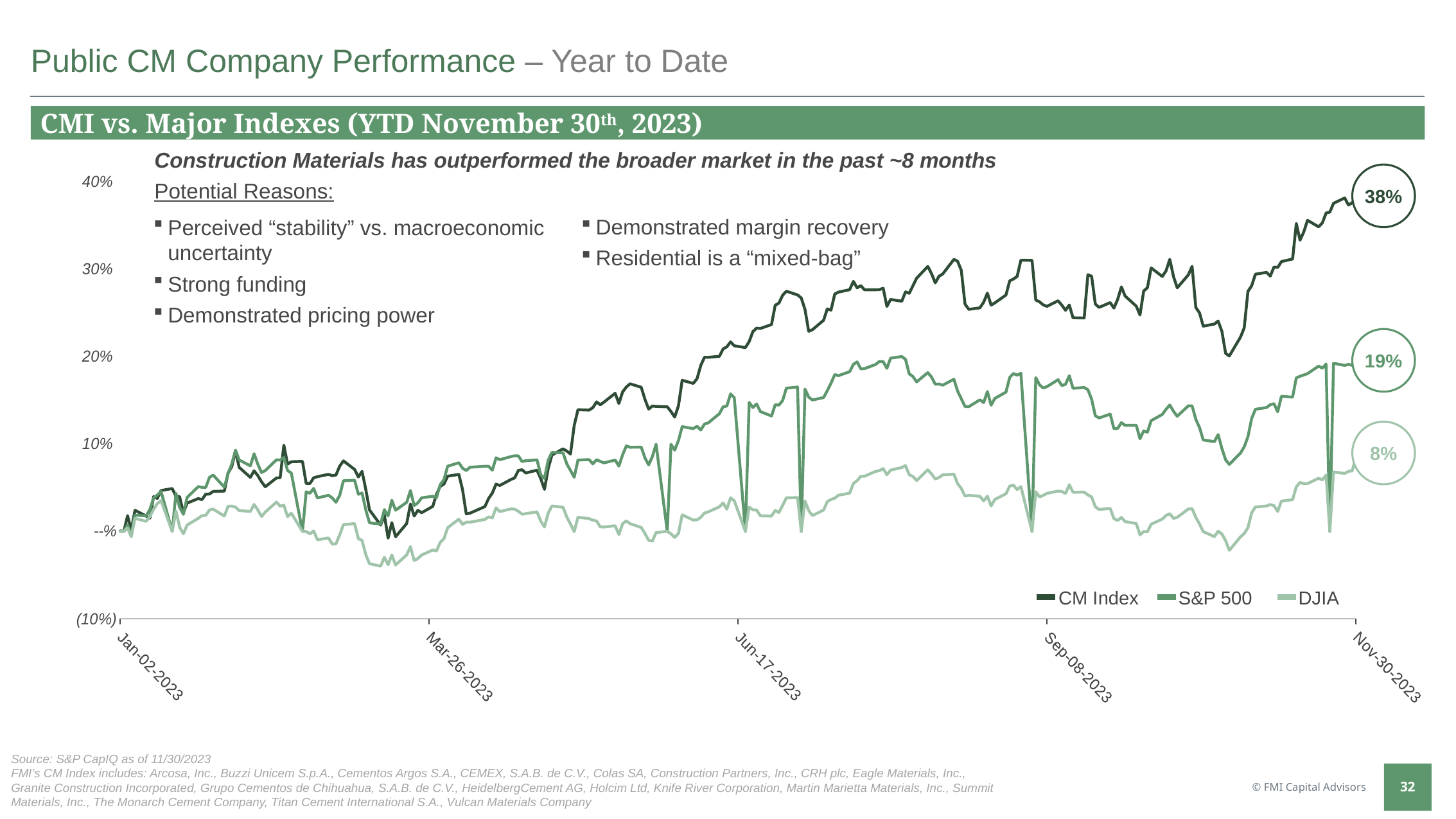
Which series has the highest value at the end of the chart? CM Index What is the year-to-date value shown for the S&P 500 at the end of the chart? 19% What is the year-to-date value shown for the CM Index at the end of the chart? 38% What is the difference between the end-of-period values of the CM Index and the S&P 500? 19 percentage points What is the title of the chart? CMI vs. Major Indexes (YTD November 30th, 2023) What is the year-to-date value shown for the DJIA at the end of the chart? 8% Is the CM Index value at the end of the chart greater or less than 30%? greater Which series has the lowest value at the end of the chart? DJIA How many series does the legend list? 3 Which is larger at the end of the chart, the S&P 500 value or the DJIA value? S&P 500 Does the CM Index generally rise or fall from Jan-02-2023 to Nov-30-2023? Rise What kind of chart is shown on the slide? Line chart